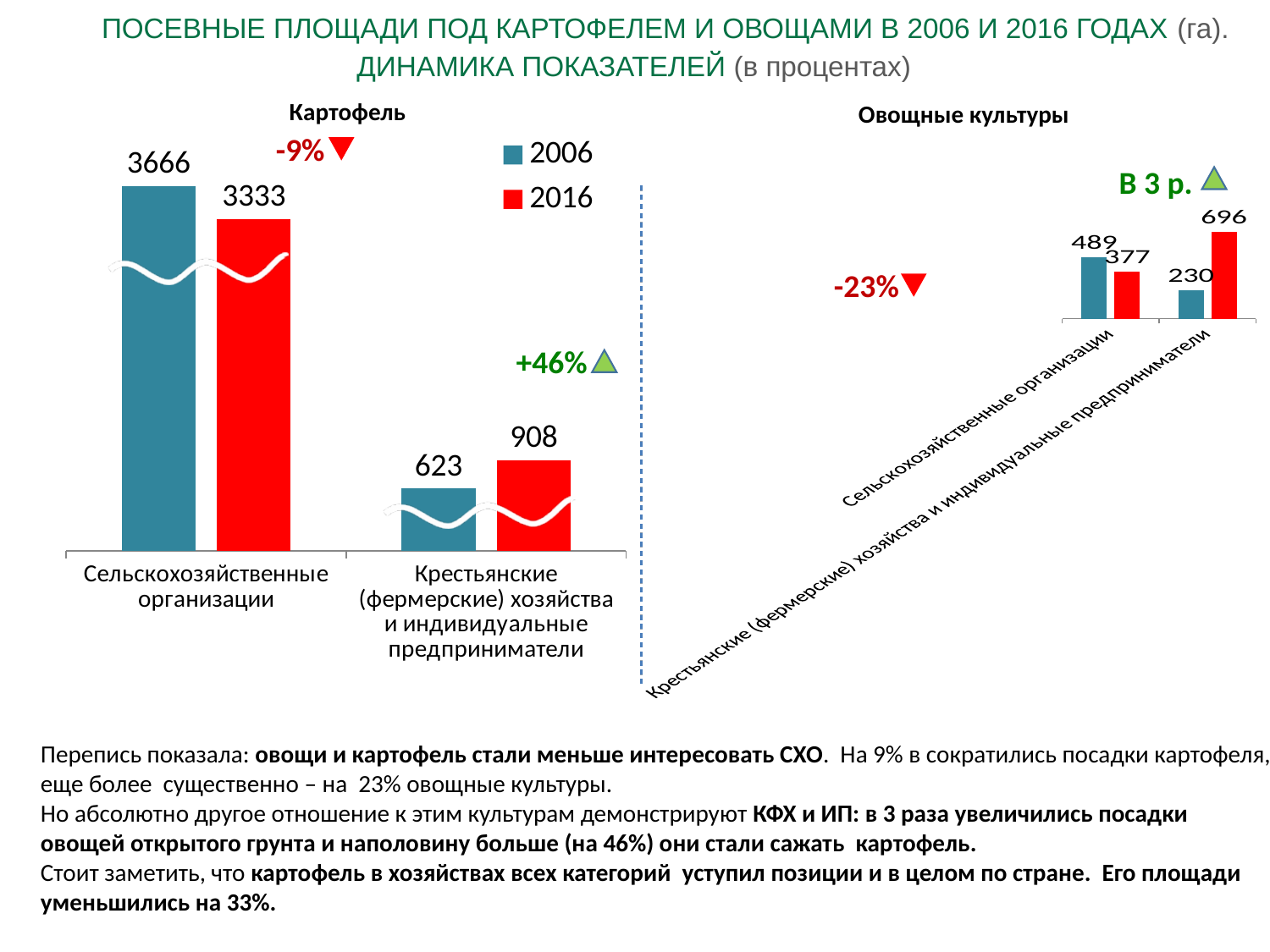
How many categories are shown in the "Овощные культуры" chart? 2 In the "Картофель" chart, which is larger for Крестьянские (фермерские) хозяйства и индивидуальные предприниматели: the 2006 value or the 2016 value? 2016 In the "Картофель" chart, what is the difference between the 2006 and 2016 values for Сельскохозяйственные организации? 333 In the "Картофель" chart, what is the value for Крестьянские (фермерские) хозяйства и индивидуальные предприниматели in 2016? 908 In the "Картофель" chart, what is the value for Сельскохозяйственные организации in 2006? 3666 What kind of chart is the "Картофель" chart? Bar chart In the "Овощные культуры" chart, what is the value for Крестьянские (фермерские) хозяйства и индивидуальные предприниматели in 2006? 230 In the "Овощные культуры" chart, which category has the lowest value in 2006? Крестьянские (фермерские) хозяйства и индивидуальные предприниматели How many series does the legend of the "Картофель" chart list? 2 In the "Овощные культуры" chart, what is the value for Сельскохозяйственные организации in 2016? 377 In the "Овощные культуры" chart, what is the difference between the 2016 and 2006 values for Крестьянские (фермерские) хозяйства и индивидуальные предприниматели? 466 In the "Овощные культуры" chart, which category has the highest value in 2016? Крестьянские (фермерские) хозяйства и индивидуальные предприниматели